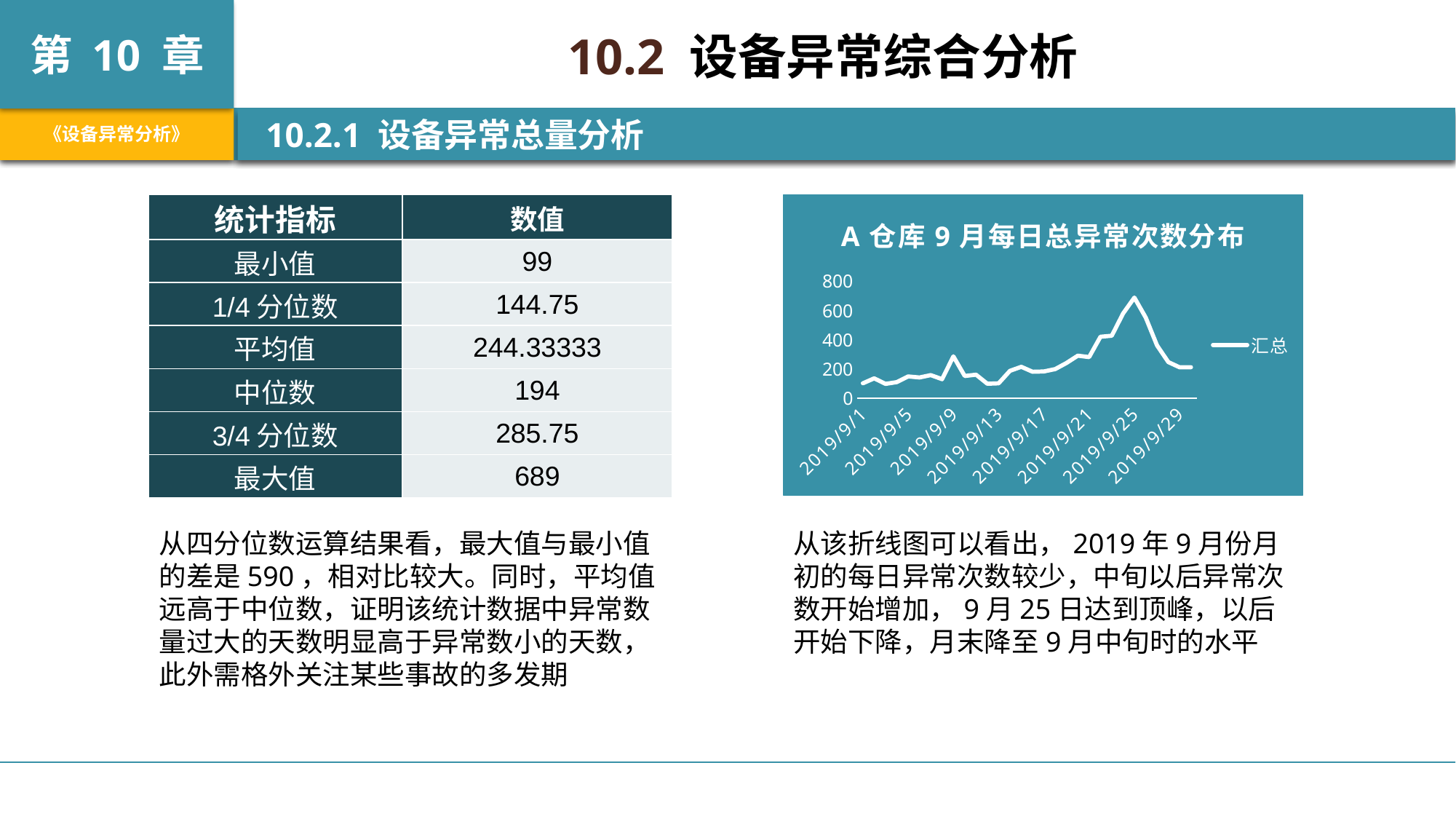
Is the peak value of the line around 2019/9/25 greater or less than 600? greater Is the value for 2019/9/1 greater or less than 200? less Does the line rise or fall between 2019/9/21 and 2019/9/25? rise What is the title of the chart on the slide? A 仓库 9 月每日总异常次数分布 Which is larger, the value for 2019/9/25 or the value for 2019/9/1? 2019/9/25 On which date does the line in the chart reach its highest value? 2019/9/25 Does the line rise or fall between 2019/9/25 and 2019/9/29? fall What kind of chart is shown on the slide? line chart How many series does the chart's legend list? 1 How many date labels are shown on the x axis of the chart? 8 Is the value for 2019/9/13 greater or less than 400? less What is the name of the series shown in the chart's legend? 汇总